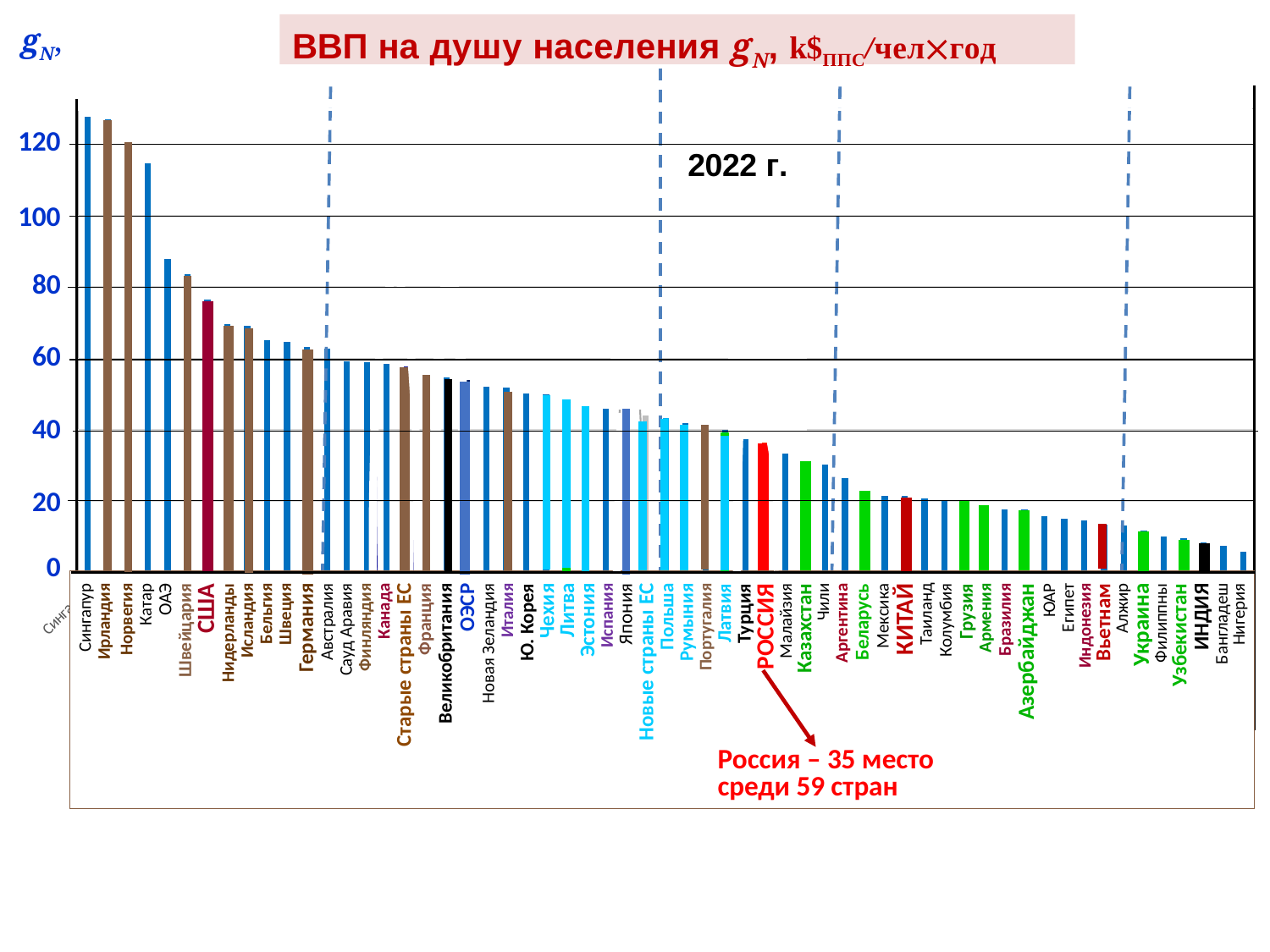
What kind of chart is shown on the slide? bar chart Which has the larger value, США or Германия? США Which year does the chart show data for? 2022 Is the value for Казахстан greater or less than 20? greater Which has the larger value, РОССИЯ or КИТАЙ? РОССИЯ Is the value for Норвегия greater or less than 100? greater Which country has the lowest GDP per capita on the chart? Нигерия Is the value for США greater or less than 60? greater According to the annotation on the chart, what place does Russia hold among the 59 countries? 35 Do the bar values rise or fall moving from left to right along the x axis? fall